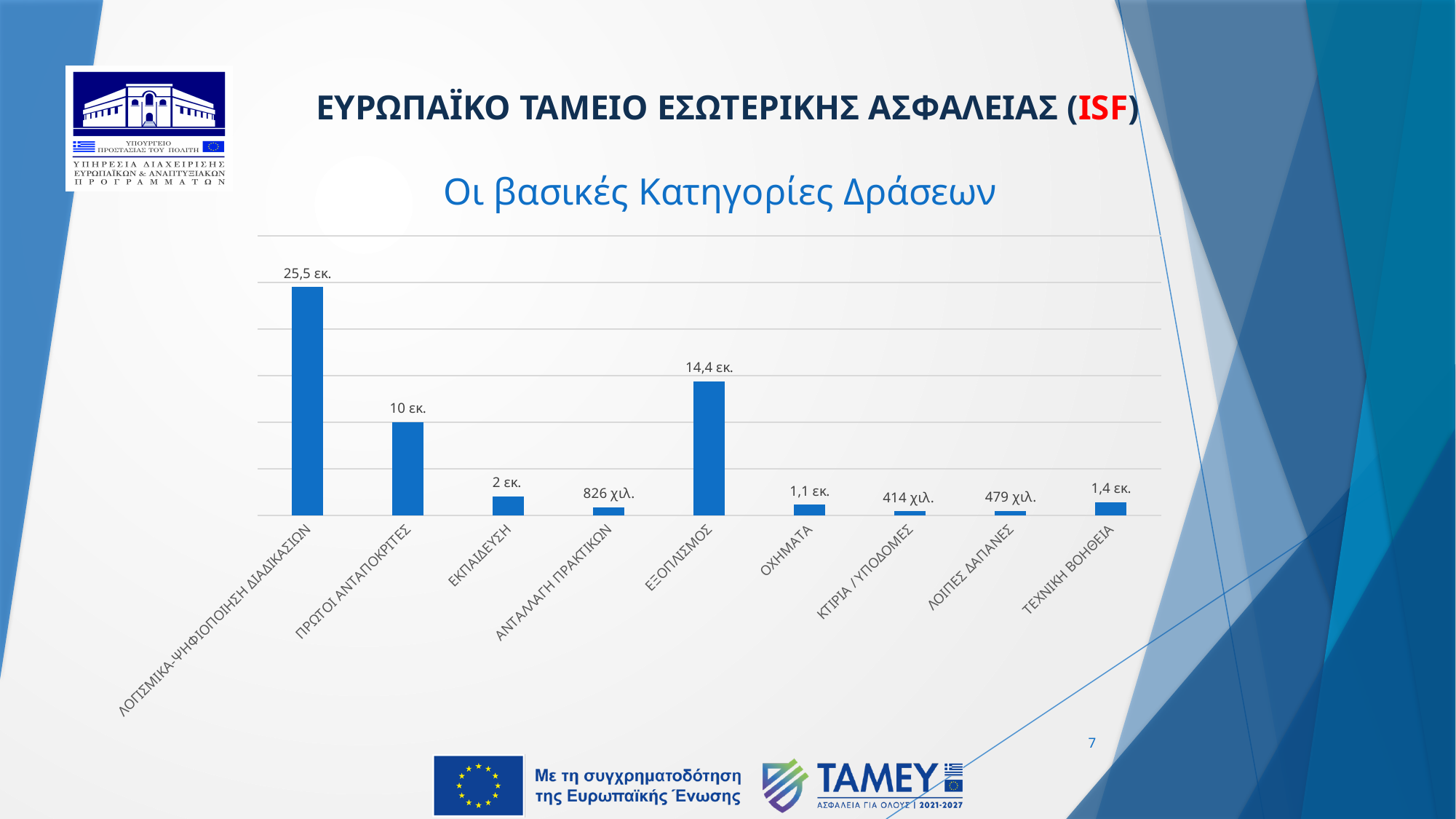
What kind of chart is shown on the slide? Bar chart What value is shown for ΑΝΤΑΛΛΑΓΗ ΠΡΑΚΤΙΚΩΝ? 826 χιλ. What is the difference between the values for ΠΡΩΤΟΙ ΑΝΤΑΠΟΚΡΙΤΕΣ and ΕΚΠΑΙΔΕΥΣΗ? 8 εκ. What is the difference between the values for ΛΟΓΙΣΜΙΚΑ-ΨΗΦΙΟΠΟΙΗΣΗ ΔΙΑΔΙΚΑΣΙΩΝ and ΕΞΟΠΛΙΣΜΟΣ? 11,1 εκ. Which category has the highest value? ΛΟΓΙΣΜΙΚΑ-ΨΗΦΙΟΠΟΙΗΣΗ ΔΙΑΔΙΚΑΣΙΩΝ Which is larger, the value for ΟΧΗΜΑΤΑ or the value for ΤΕΧΝΙΚΗ ΒΟΗΘΕΙΑ? ΤΕΧΝΙΚΗ ΒΟΗΘΕΙΑ What is the subtitle shown above the chart? Οι βασικές Κατηγορίες Δράσεων What value is shown for ΕΞΟΠΛΙΣΜΟΣ? 14,4 εκ. How many categories are shown in the chart? 9 What value is shown for ΤΕΧΝΙΚΗ ΒΟΗΘΕΙΑ? 1,4 εκ. Which category has the lowest value? ΚΤΙΡΙΑ / ΥΠΟΔΟΜΕΣ What value is shown for ΠΡΩΤΟΙ ΑΝΤΑΠΟΚΡΙΤΕΣ? 10 εκ.